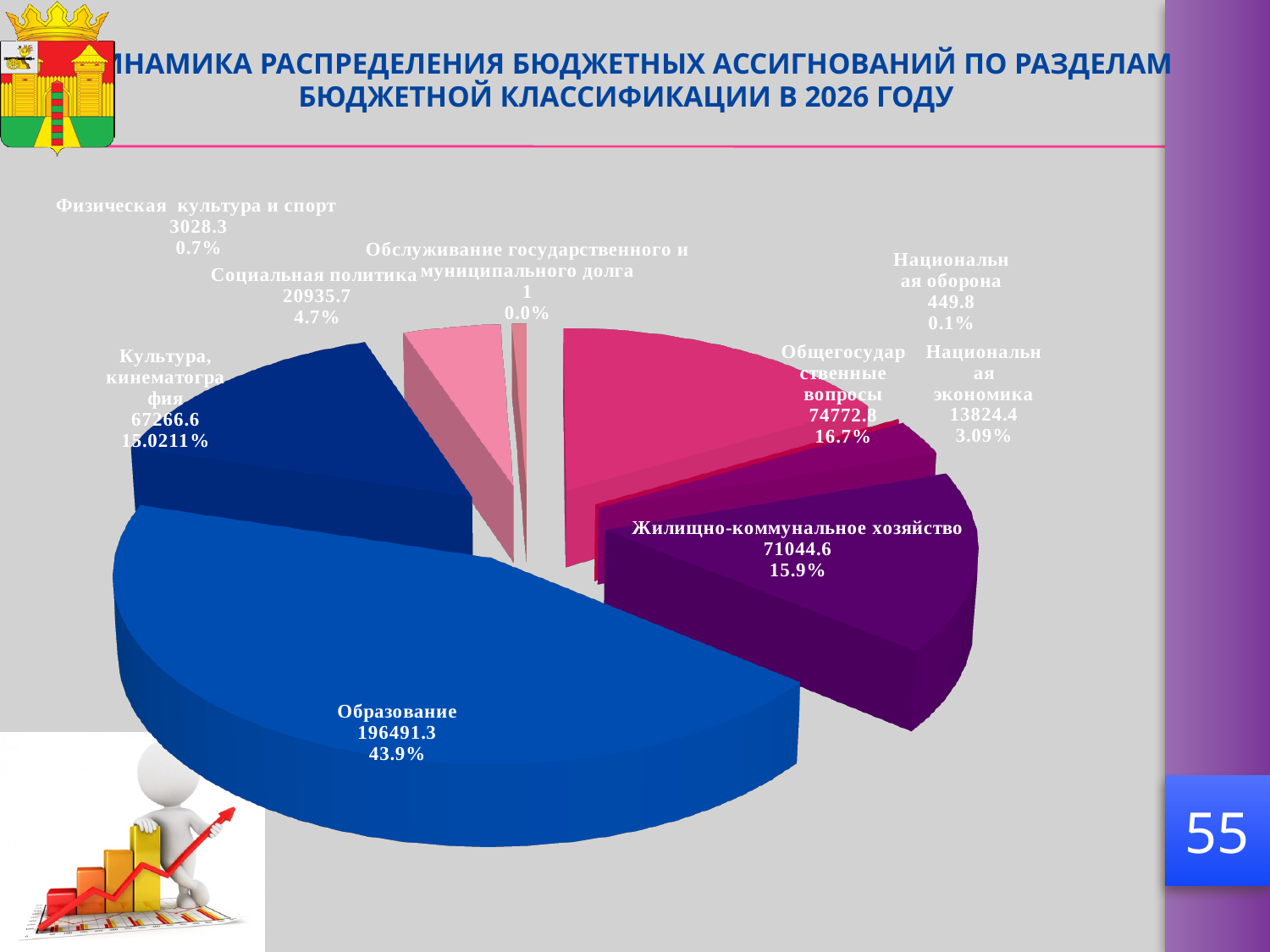
How many categories are shown in the pie chart? 9 What is the difference between the values for Общегосударственные вопросы and Жилищно-коммунальное хозяйство? 3728.2 Which is larger, Общегосударственные вопросы or Жилищно-коммунальное хозяйство? Общегосударственные вопросы What share of the pie does Социальная политика represent? 4.7% What share of the pie does Общегосударственные вопросы represent? 16.7% Which category has the largest value? Образование What kind of chart is shown on the slide? pie chart What is the value for Национальная оборона? 449.8 Which category has the smallest value? Обслуживание государственного и муниципального долга What is the value for Жилищно-коммунальное хозяйство? 71044.6 What share of the pie does Образование represent? 43.9% What is the value for Образование? 196491.3